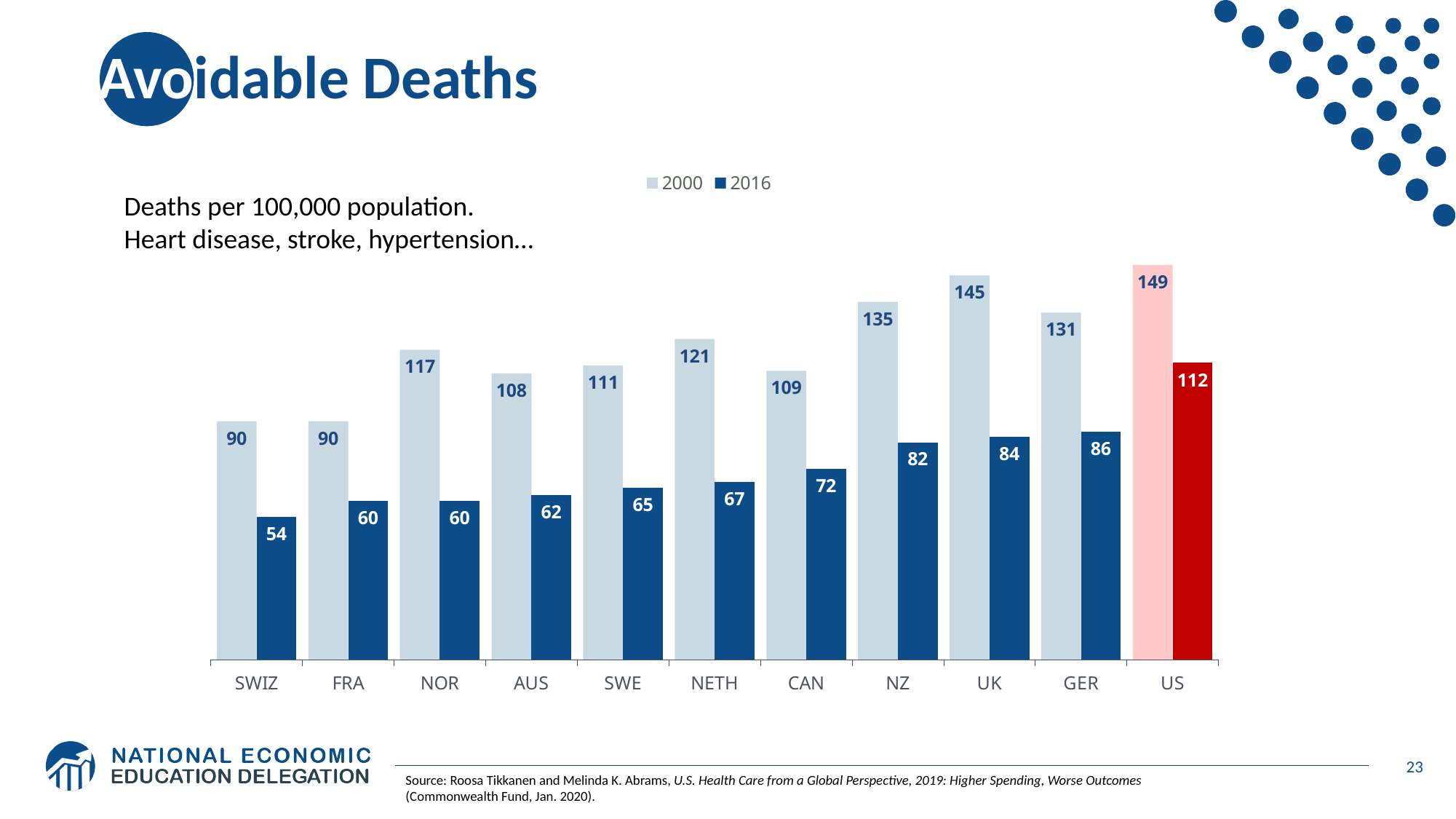
Which country had the highest value in 2016? US What was the value for the US in 2000? 149 What is the difference between the 2000 values for the UK and Germany (GER)? 14 What is the difference between the US values for 2000 and 2016? 37 What was the value for the UK in 2000? 145 Which is larger: the 2016 value for Germany (GER) or the 2016 value for the UK? GER What was the value for Switzerland (SWIZ) in 2016? 54 Which country had the lowest value in 2016? SWIZ What kind of chart is shown on the slide? Bar chart How many series does the legend list? 2 Which series is shown in the lighter colour in the legend? 2000 How many countries are shown on the x axis? 11